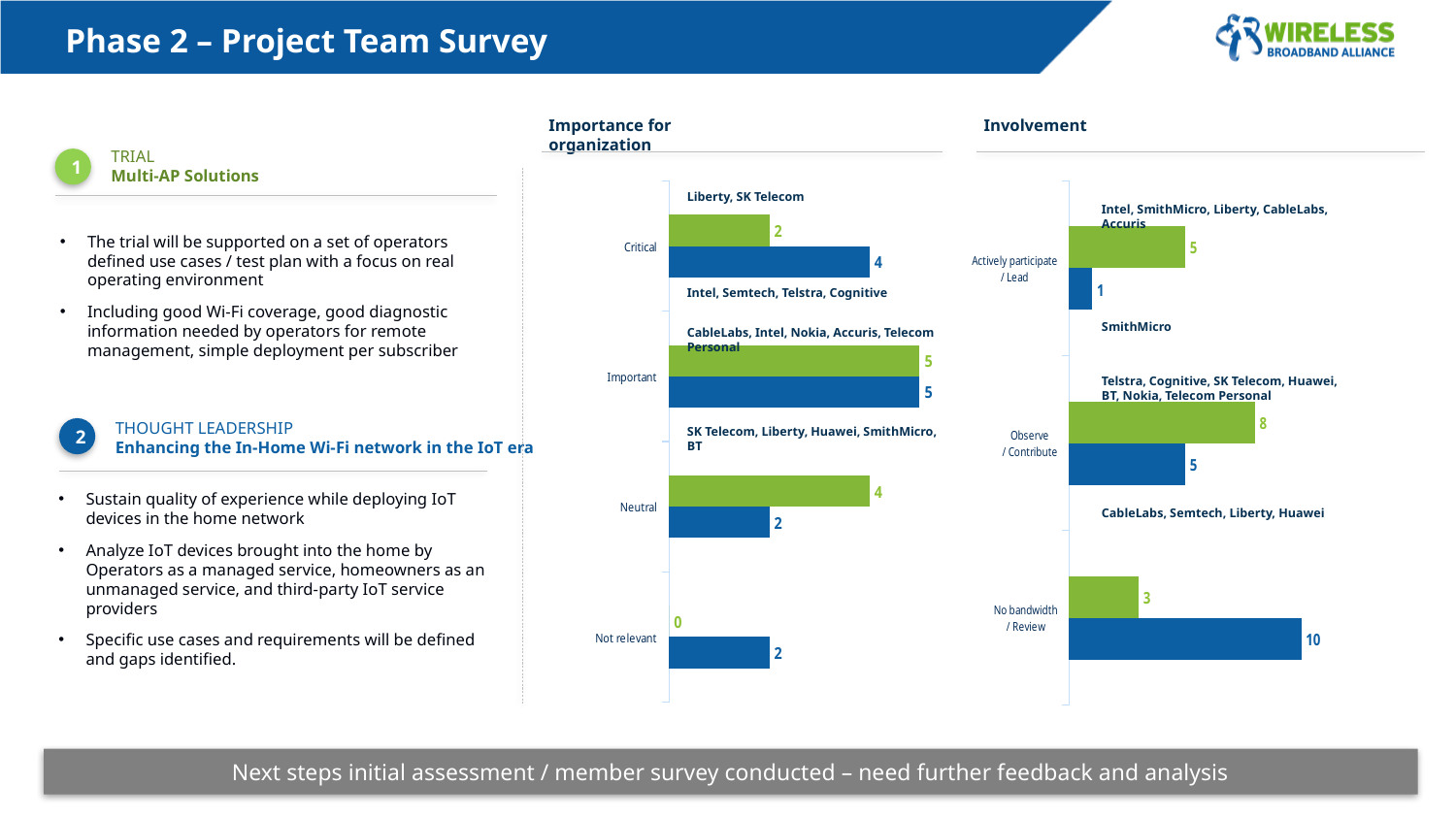
In the 'Involvement' chart, what is the value of the blue bar for No bandwidth / Review? 10 In the 'Involvement' chart, what is the difference between the blue bar and the green bar for No bandwidth / Review? 7 In the 'Importance for organization' chart, what is the value of the blue bar for Critical? 4 In the 'Involvement' chart, what is the value of the green bar for Observe / Contribute? 8 In the 'Importance for organization' chart, what is the total of the green and blue bars for Important? 10 How many categories are shown in the 'Importance for organization' chart? 4 In the 'Importance for organization' chart, what is the value of the green bar for Neutral? 4 In the 'Importance for organization' chart, what is the value of the green bar for Not relevant? 0 In the 'Importance for organization' chart, which is larger for Critical, the green bar or the blue bar? the blue bar What type of chart is the 'Involvement' chart? bar chart In the 'Involvement' chart, which category has the lowest blue bar? Actively participate / Lead In the 'Involvement' chart, which category has the highest green bar? Observe / Contribute